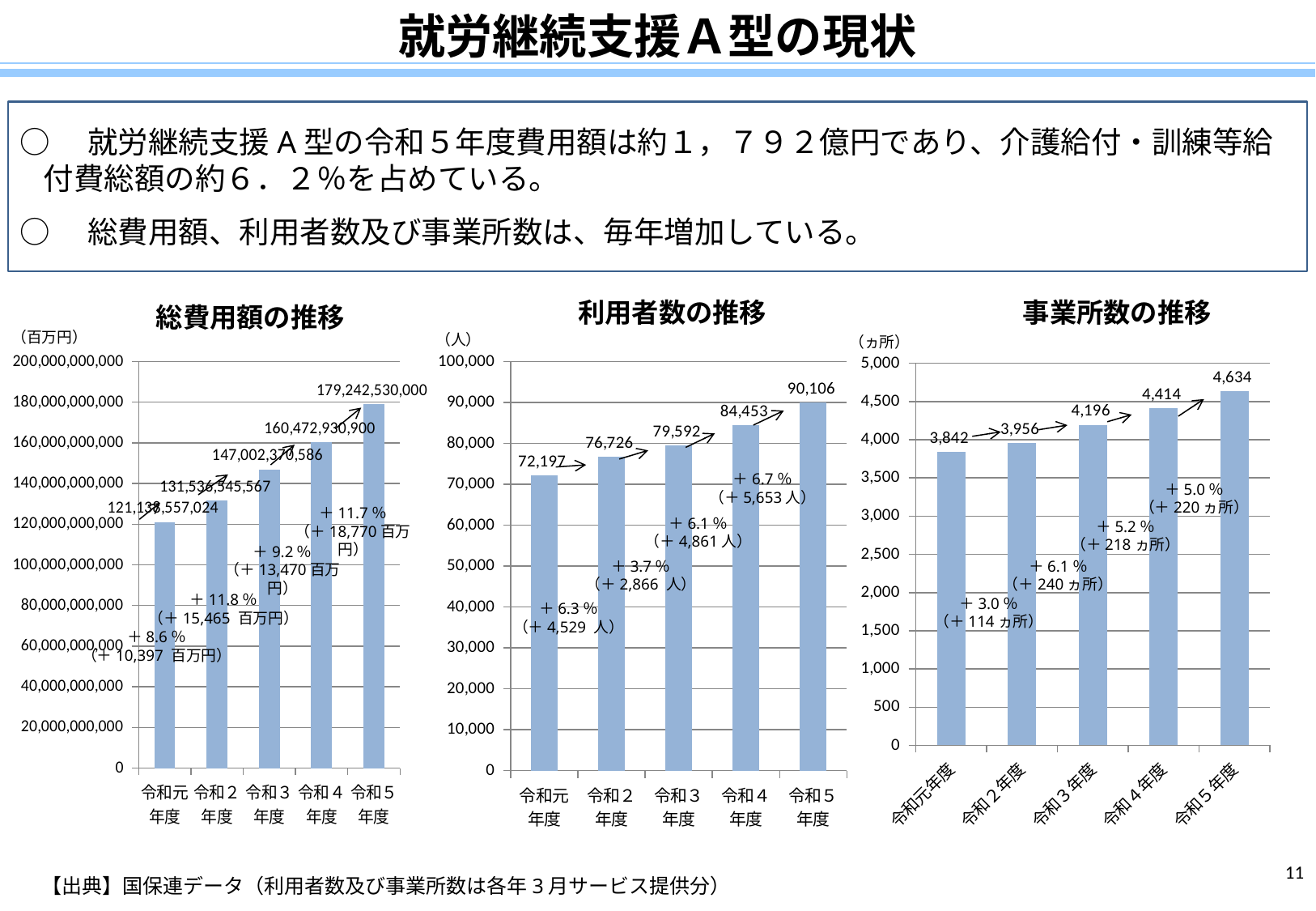
In the 利用者数の推移 chart, what is the value for 令和５年度? 90,106 In the 事業所数の推移 chart, what is the value for 令和３年度? 4,196 In the 利用者数の推移 chart, which year has the lowest value? 令和元年度 In the 事業所数の推移 chart, do the values rise or fall from 令和元年度 to 令和５年度? rise In the 利用者数の推移 chart, what is the difference between 令和４年度 and 令和３年度? 4,861 In the 事業所数の推移 chart, is the value for 令和元年度 greater or less than 4,000? less In the 事業所数の推移 chart, which year has the highest value? 令和５年度 In the 利用者数の推移 chart, what is the value for 令和元年度? 72,197 In the 事業所数の推移 chart, what is the difference between 令和５年度 and 令和４年度? 220 How many years are shown in the 総費用額の推移 chart? 5 What kind of chart is the 利用者数の推移 chart? bar chart In the 総費用額の推移 chart, what is the value for 令和５年度? 179,242,530,000